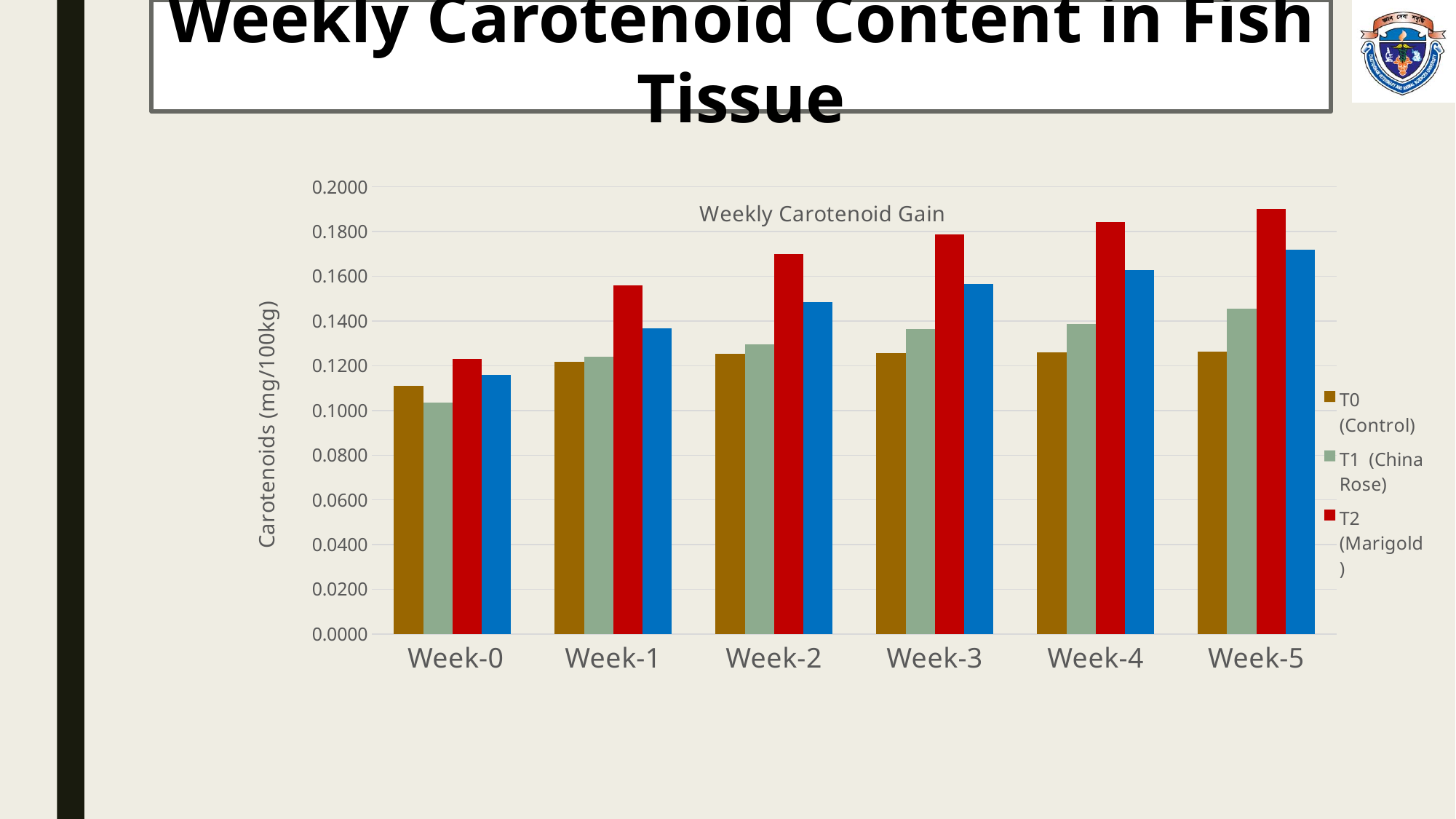
What kind of chart is shown on the slide? bar chart Is the value for T1 (China Rose) at Week-5 greater or less than 0.1400? greater What is the label on the vertical axis? Carotenoids (mg/100kg) Is the value for T0 (Control) at Week-0 greater or less than 0.1200? less Which week has the highest value for T2 (Marigold)? Week-5 Which week has the lowest value for T1 (China Rose)? Week-0 Do the values for T2 (Marigold) rise or fall from Week-0 to Week-5? rise Is the value for T2 (Marigold) at Week-5 greater or less than 0.1800? greater How many week categories are shown on the x axis? 6 What is the title printed inside the chart area? Weekly Carotenoid Gain At Week-3, which is larger: T2 (Marigold) or T0 (Control)? T2 (Marigold)